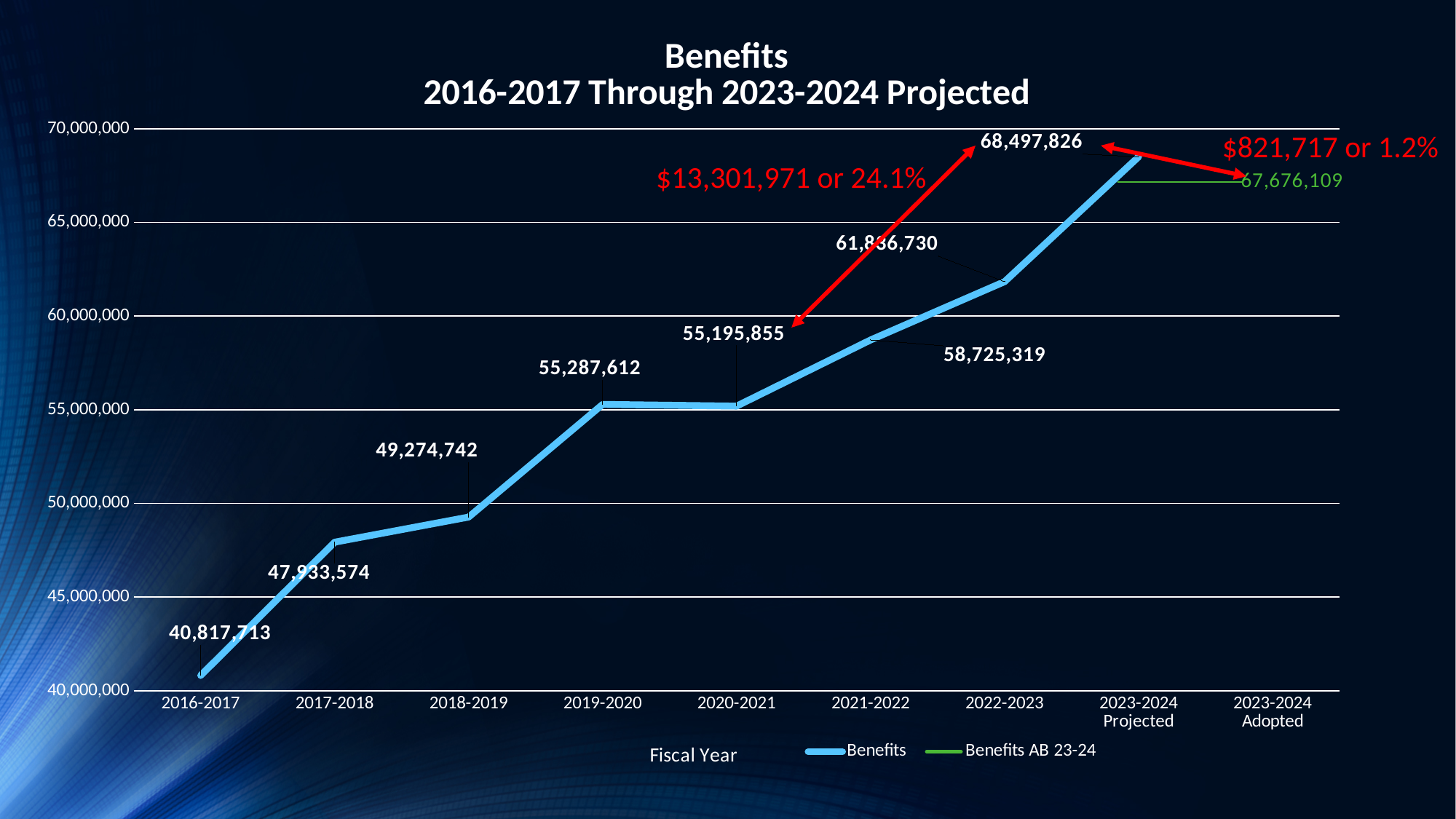
What is the title of the x axis? Fiscal Year What is the Benefits value for 2023-2024 Projected? 68,497,826 How many series does the legend list? 2 What is the Benefits value for 2016-2017? 40,817,713 What is the difference between the Benefits values for 2017-2018 and 2016-2017? 7,115,861 Which fiscal year has the highest Benefits value? 2023-2024 Projected What kind of chart is shown on the slide? line chart What is the value shown for 2023-2024 Adopted (Benefits AB 23-24)? 67,676,109 What is the Benefits value for 2019-2020? 55,287,612 Is the Benefits value for 2021-2022 greater or less than 60,000,000? less Which has the larger Benefits value, 2019-2020 or 2020-2021? 2019-2020 Which fiscal year has the lowest Benefits value? 2016-2017